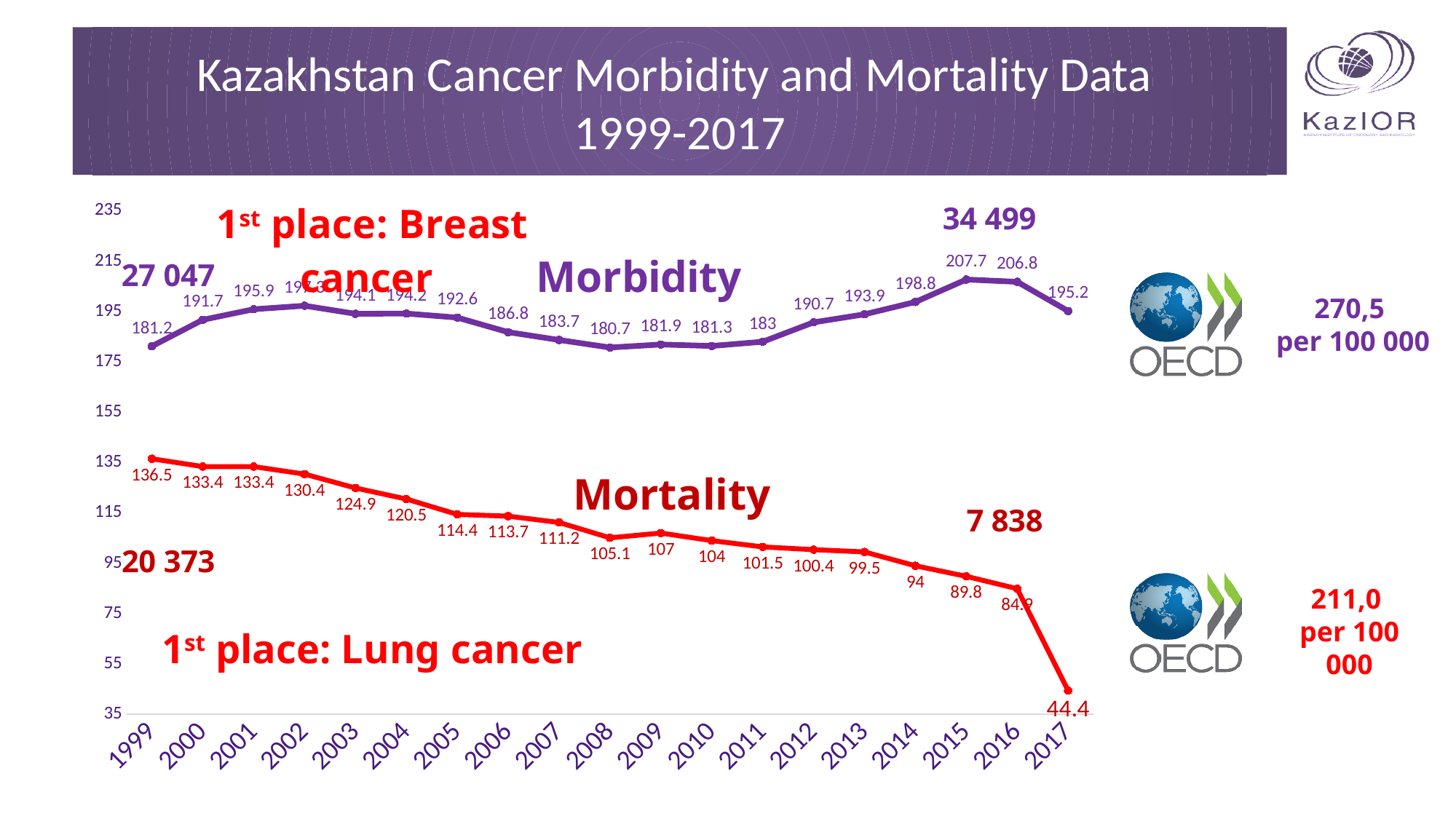
What is the Mortality value for 2017? 44.4 How many data series are plotted on the chart? 2 Which is larger, the Mortality value for 2004 or the Mortality value for 2010? 2004 How many years are shown on the x axis? 19 What is the Mortality value for 1999? 136.5 What is the Morbidity value for 2015? 207.7 What kind of chart is shown on the slide? line chart In which year is the Mortality series at its lowest? 2017 Does the Mortality series generally rise or fall from 1999 to 2017? fall In which year is the Morbidity series at its highest? 2015 What is the Morbidity value for 2008? 180.7 What is the difference between the Morbidity value in 2015 and the Morbidity value in 1999? 26.5